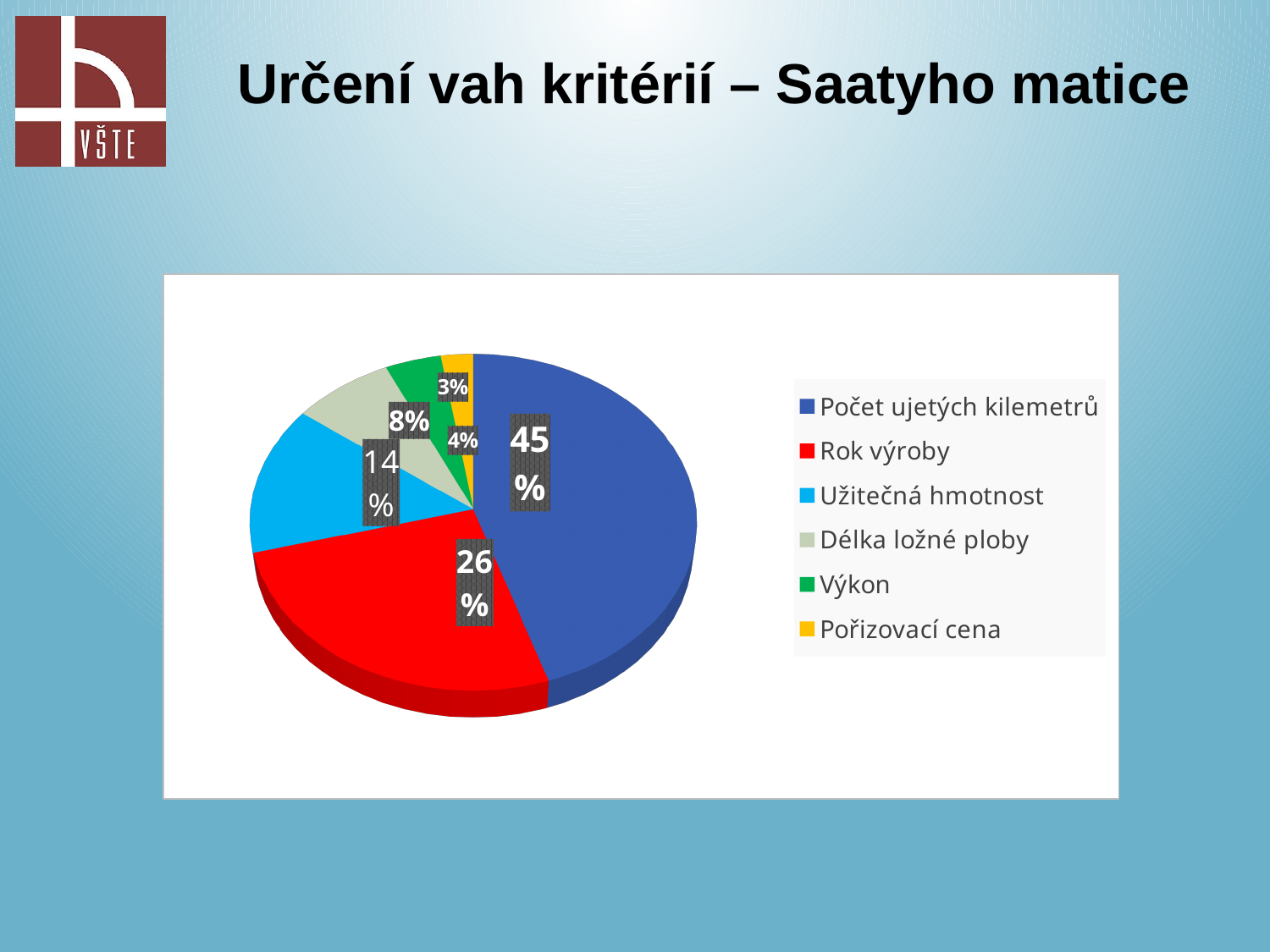
What share of the pie does Počet ujetých kilemetrů have? 45% What share of the pie does Pořizovací cena have? 3% What colour is the slice for Pořizovací cena? yellow What share of the pie does Užitečná hmotnost have? 14% Which category has the largest slice of the pie? Počet ujetých kilemetrů What is the difference in percentage points between Počet ujetých kilemetrů and Rok výroby? 19 Which category has the smallest slice of the pie? Pořizovací cena How many categories does the legend list? 6 What is the combined share of Počet ujetých kilemetrů and Rok výroby? 71% Which is larger, the slice for Rok výroby or the slice for Užitečná hmotnost? Rok výroby What type of chart is shown on the slide? pie chart What share of the pie does Rok výroby have? 26%